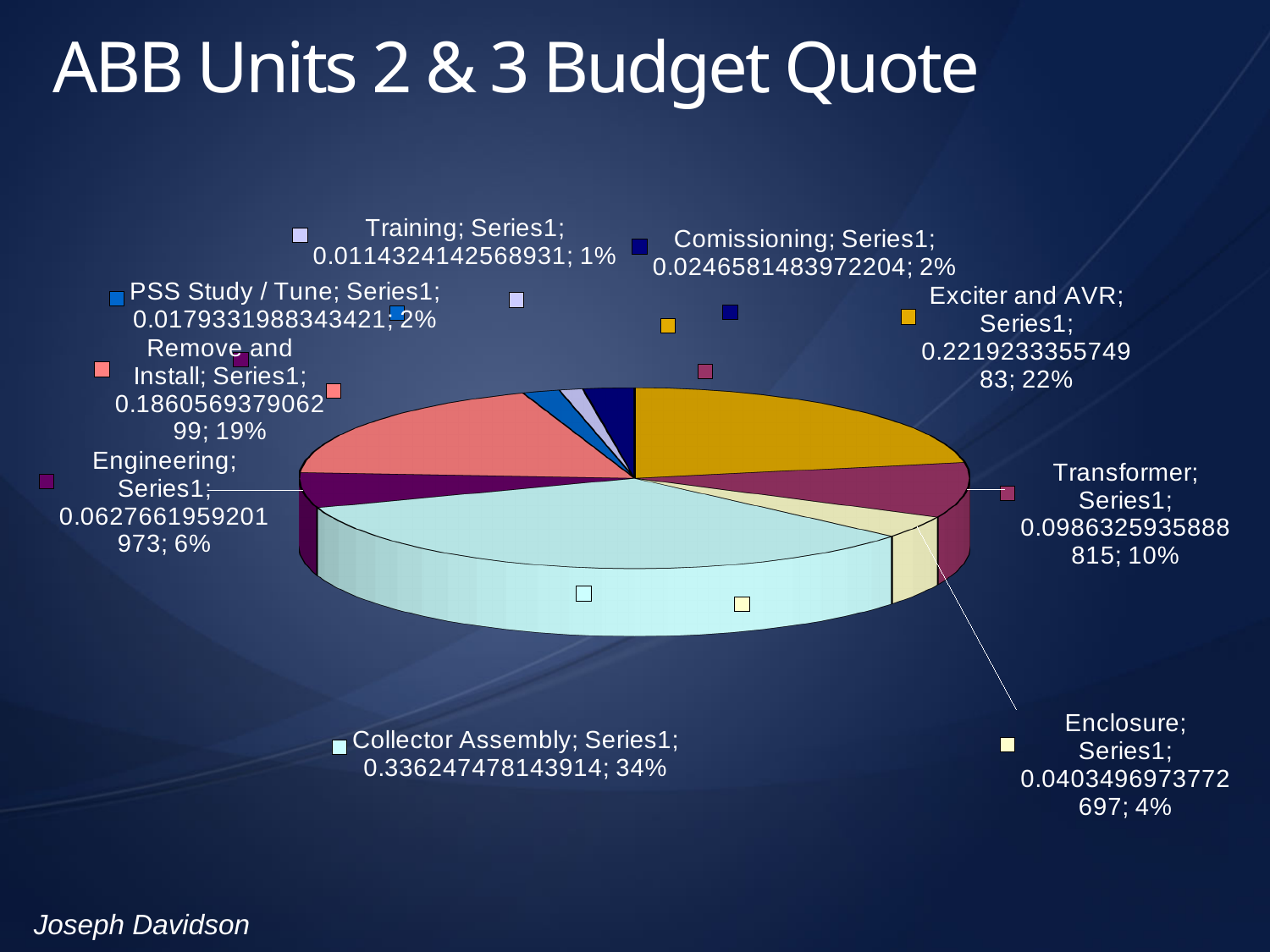
How many categories are shown in the pie chart? 9 What is the title of the slide containing the pie chart? ABB Units 2 & 3 Budget Quote What percentage share does Collector Assembly have in the pie chart? 34% What percentage share does Remove and Install have in the pie chart? 19% Which category has the largest share of the pie chart? Collector Assembly What is the difference in percentage points between the shares of Collector Assembly and Exciter and AVR? 12 Which has a larger share, Engineering or Transformer? Transformer What percentage share does Exciter and AVR have in the pie chart? 22% What kind of chart is shown on the slide? pie chart Which category has the smallest share of the pie chart? Training